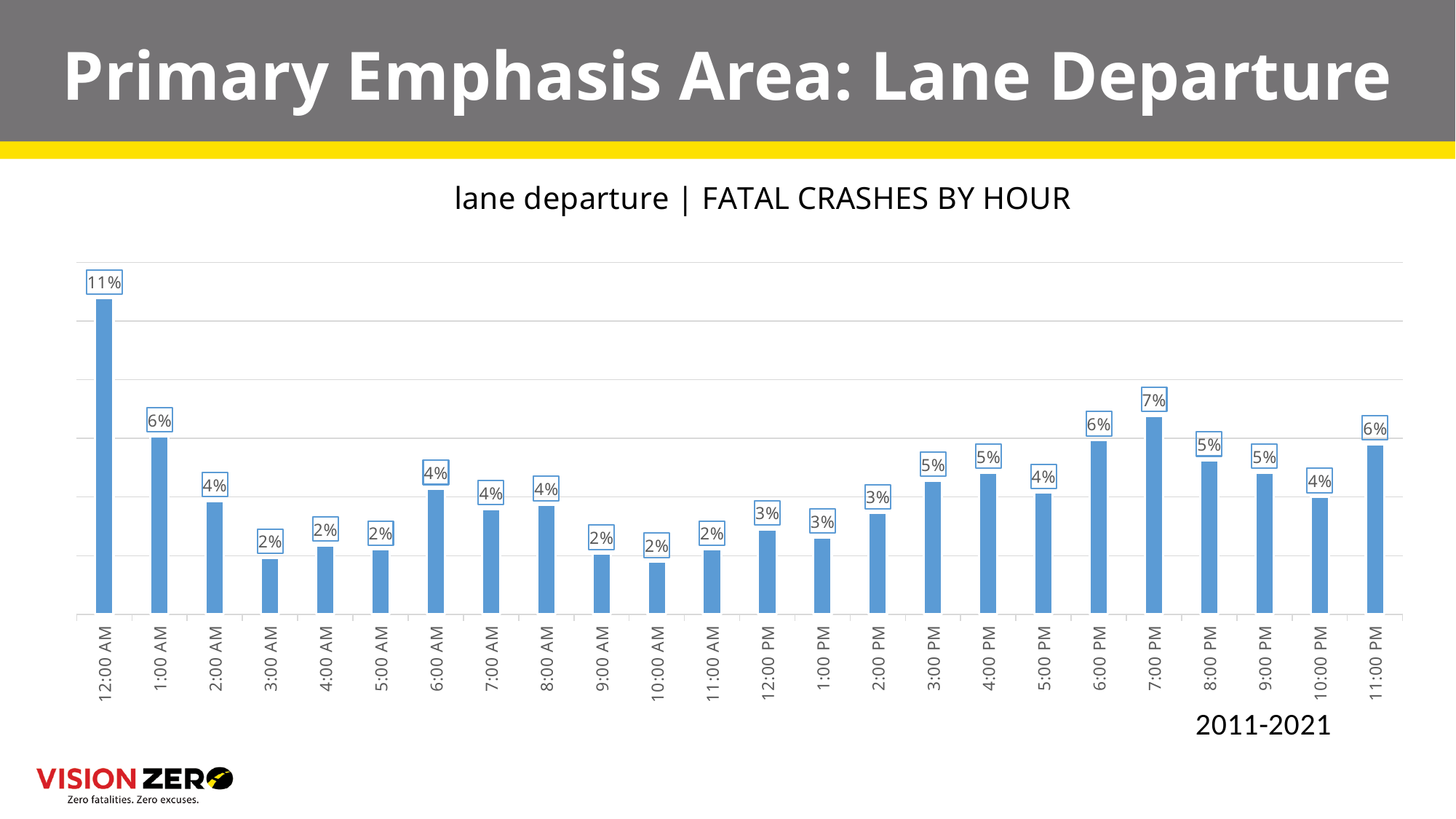
What is the value shown for 10:00 AM? 2% Which hour has the highest share of fatal crashes? 12:00 AM How many hourly categories are shown on the x axis? 24 Which is larger, the value for 6:00 PM or the value for 2:00 PM? 6:00 PM Do the values rise or fall from 12:00 AM to 3:00 AM? fall What is the title of the chart? lane departure | FATAL CRASHES BY HOUR What is the lowest percentage value shown on the chart? 2% What is the value shown for 3:00 PM? 5% What is the value shown for 7:00 PM? 7% What percentage of lane departure fatal crashes occurred at 12:00 AM? 11% What is the difference between the values for 12:00 AM and 7:00 PM? 4 percentage points What kind of chart is shown on the slide? bar chart